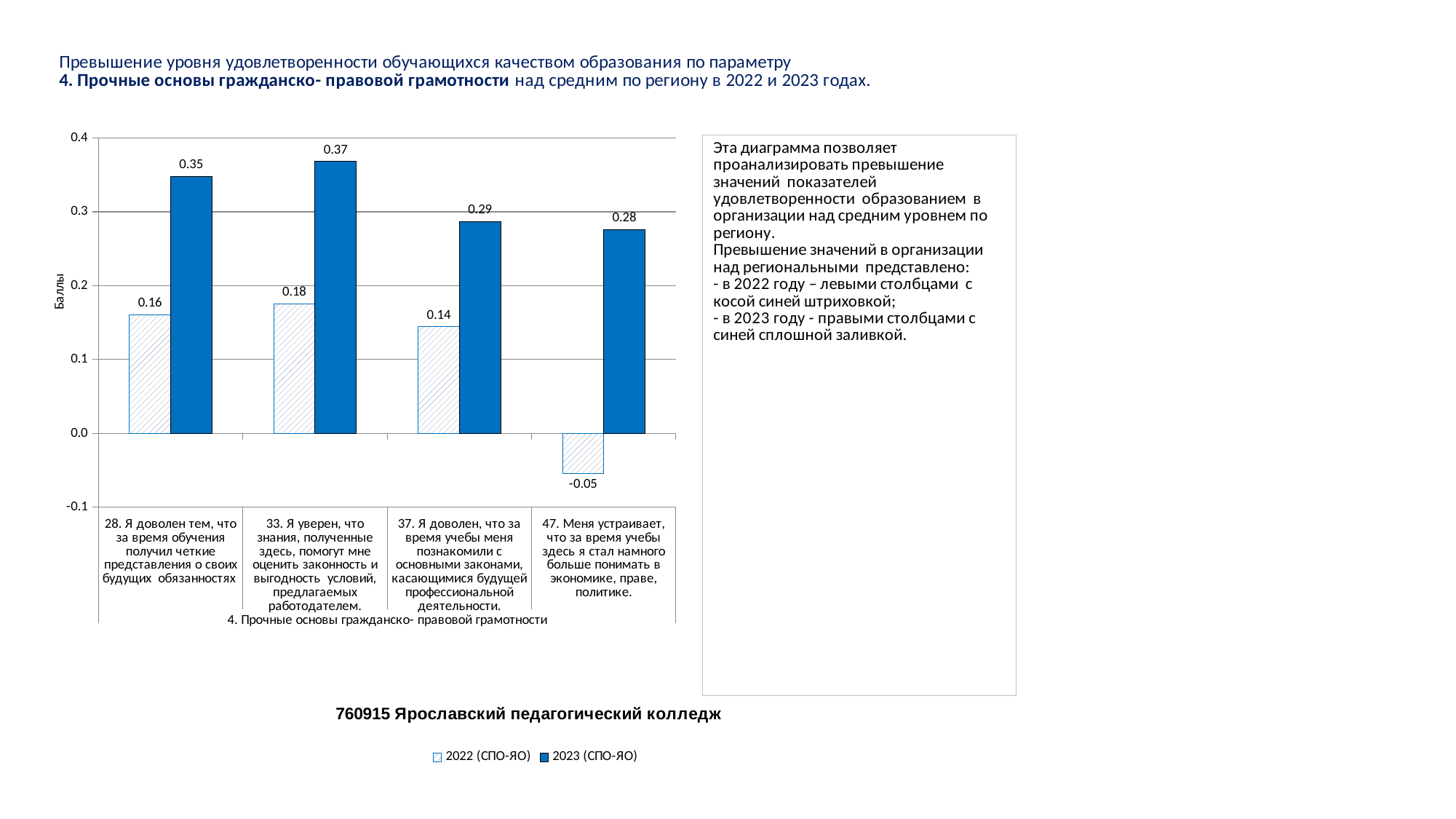
Which is larger for item 47: the 2022 (СПО-ЯО) value or the 2023 (СПО-ЯО) value? 2023 (СПО-ЯО) What kind of chart is shown on the slide? bar chart How many items (categories) are shown on the x axis? 4 What is the 2023 (СПО-ЯО) value for item 33? 0.37 What is the 2022 (СПО-ЯО) value for item 47? -0.05 How many series does the legend list? 2 Which item has the lowest 2022 (СПО-ЯО) value? 47 What is the 2023 (СПО-ЯО) value for item 37? 0.29 What is the label of the vertical axis? Баллы What is the 2022 (СПО-ЯО) value for item 28? 0.16 Which item has the highest 2023 (СПО-ЯО) value? 33 What is the difference between the 2023 and 2022 values for item 28? 0.19